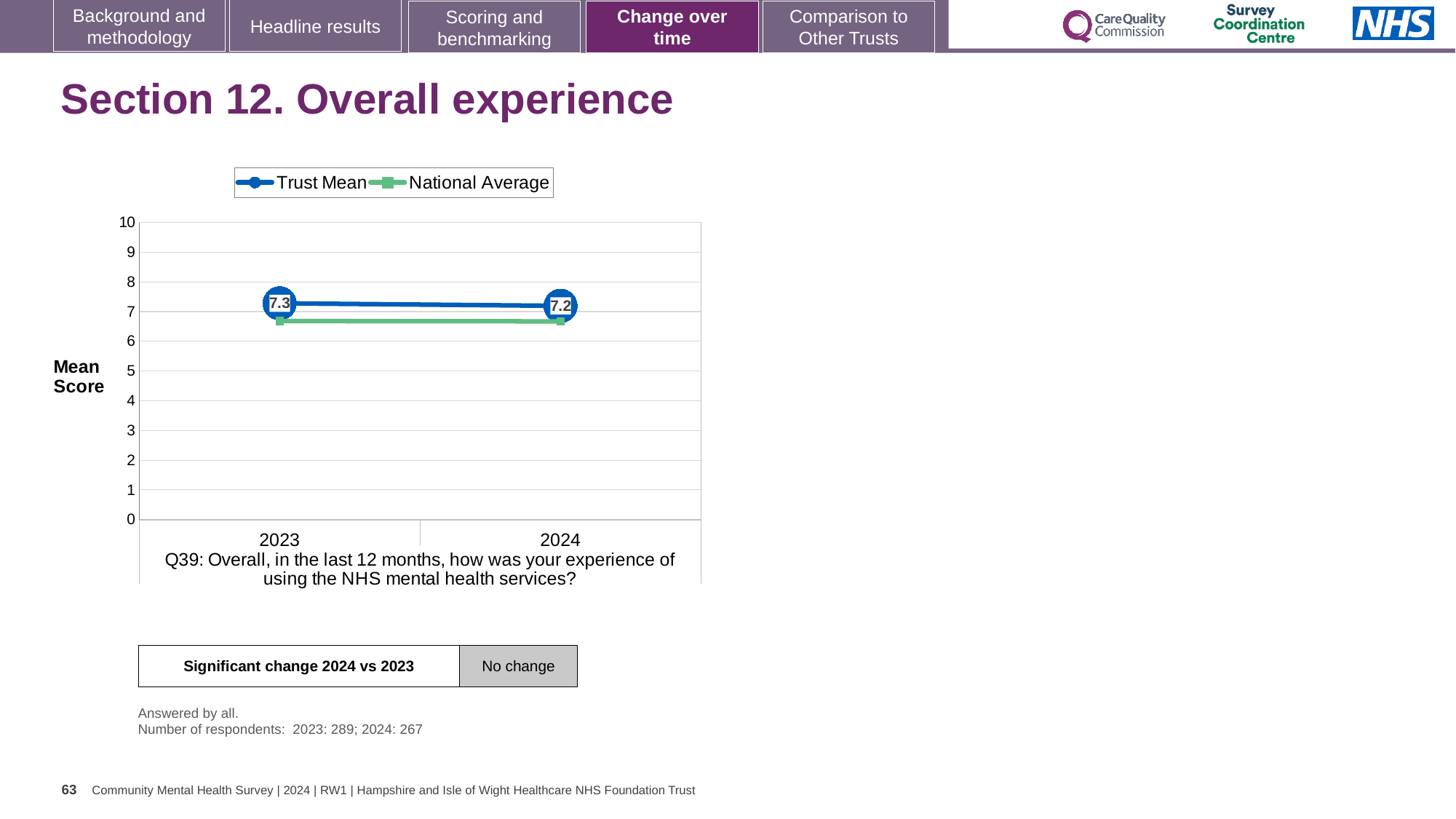
Which year has the higher Trust Mean score, 2023 or 2024? 2023 Is the National Average value for 2024 greater or less than 6? greater Does the Trust Mean rise or fall from 2023 to 2024? Fall What is the label on the y axis of the chart? Mean Score What is the Trust Mean score for 2023? 7.3 How many series does the chart legend list? 2 By how much did the Trust Mean change between 2023 and 2024? 0.1 What type of chart is shown on the slide? Line chart In 2024, which series is higher: Trust Mean or National Average? Trust Mean What is the Trust Mean score for 2024? 7.2 How many years are plotted on the x axis of the chart? 2 Is the National Average value for 2023 greater or less than 7? less